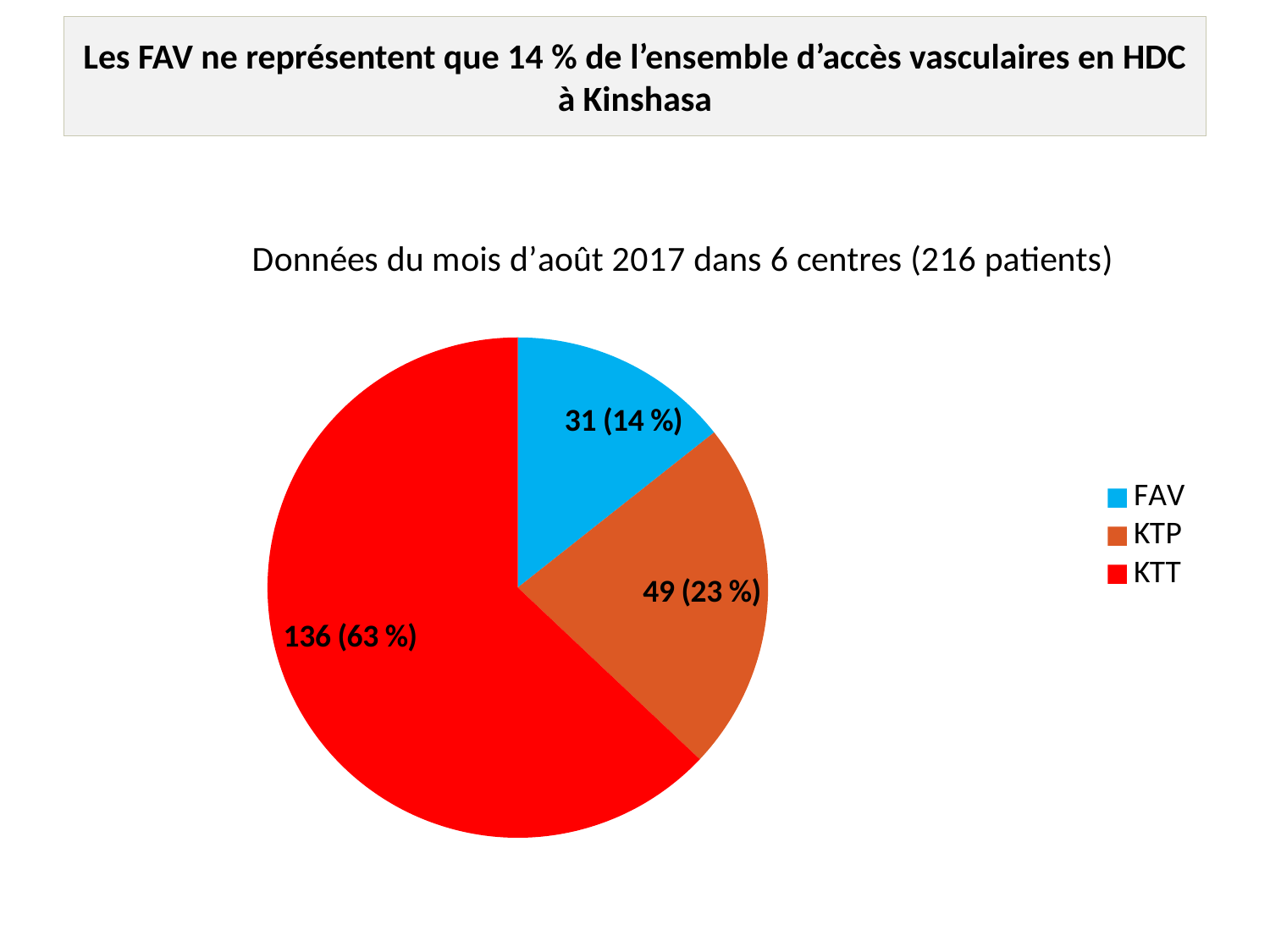
What kind of chart is shown on the slide? pie chart What is the data label for the FAV slice? 31 (14 %) What share of the pie does FAV represent? 14 % How many categories does the legend list? 3 What is the difference in patient count between KTT and KTP? 87 Which category has the largest slice of the pie? KTT What is the data label for the KTP slice? 49 (23 %) What is the data label for the KTT slice? 136 (63 %) What is the title of the chart? Données du mois d'août 2017 dans 6 centres (216 patients) Which category has the smallest slice of the pie? FAV What share of the pie does KTT represent? 63 % Which is larger, the KTP slice or the FAV slice? KTP